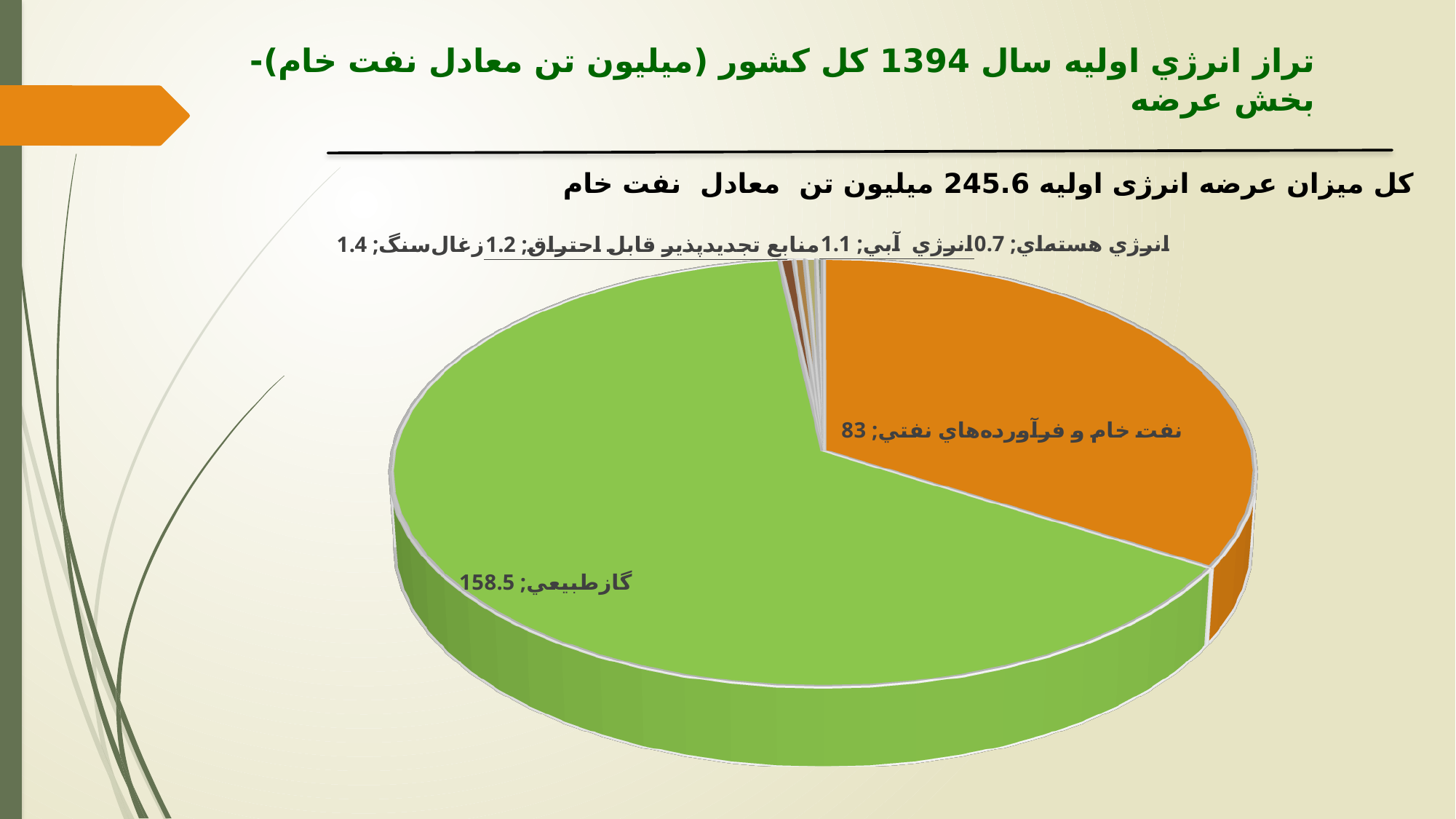
Which category has the largest slice of the pie? گاز طبيعي What kind of chart is shown on the slide? pie chart What is the value for انرژي آبي (hydro energy)? 1.1 How many slices does the pie chart have? 6 What is the value for نفت خام و فرآورده‌هاي نفتي (crude oil and petroleum products)? 83 Which category has the smallest value in the pie chart? انرژي هسته‌اي What colour is the slice for گاز طبيعي? green What is the difference between the values for گاز طبيعي and نفت خام و فرآورده‌هاي نفتي? 75.5 What is the value for زغال‌سنگ (coal)? 1.4 What is the value for گاز طبيعي (natural gas) in the pie chart? 158.5 Which is larger, the value for زغال‌سنگ or the value for منابع تجديدپذير قابل احتراق? زغال‌سنگ What is the value for انرژي هسته‌اي (nuclear energy)? 0.7